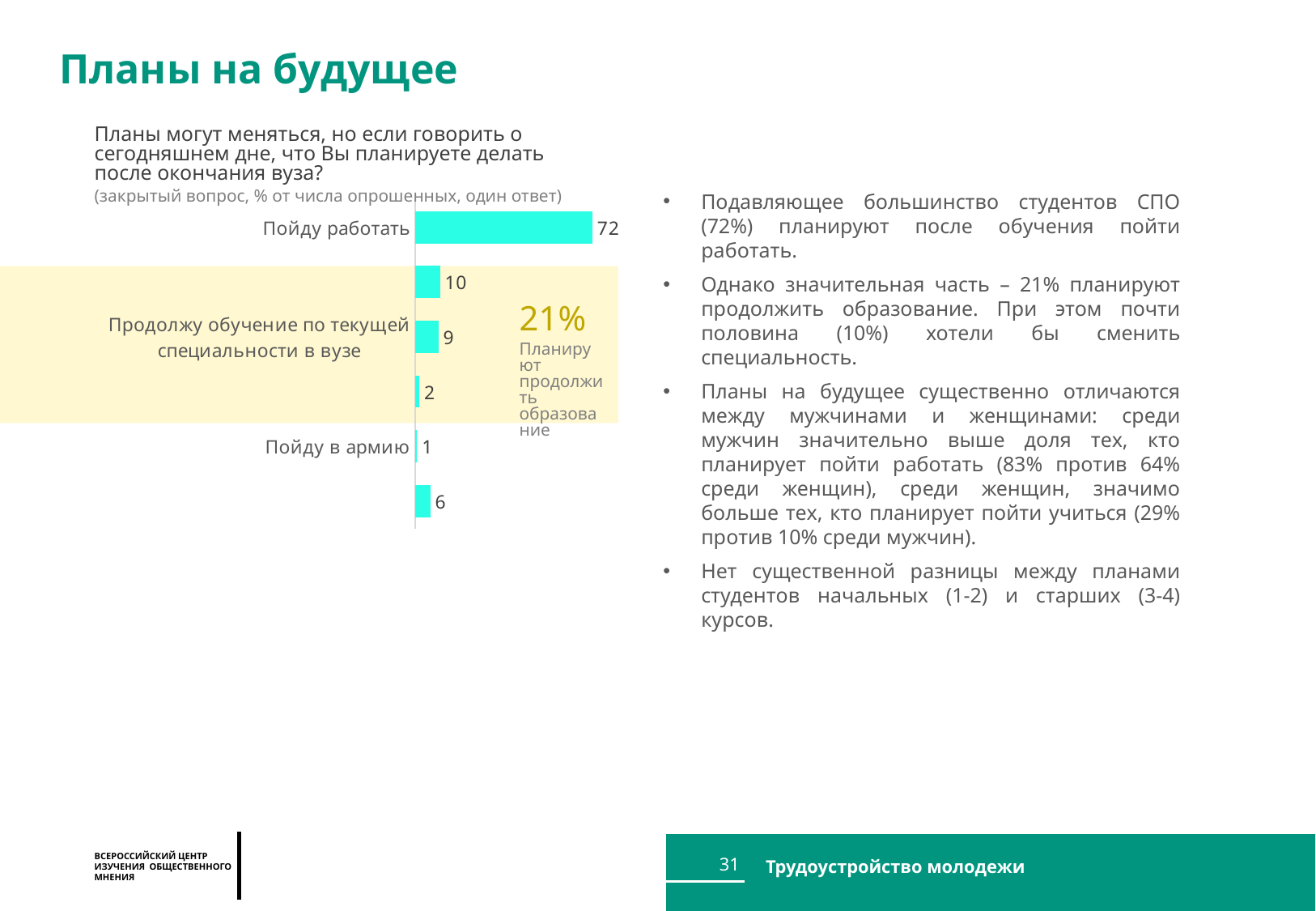
What type of chart is shown on the slide? Bar chart Which is larger, the value for "Пойду работать" or the value for "Пойду в армию"? Пойду работать Which category has the highest value in the chart? Пойду работать How many bars are plotted in the chart? 6 What is the total of the three bars in the yellow highlighted area (10, 9 and 2)? 21 What is the difference between the values for "Пойду работать" and "Пойду в армию"? 71 What value is shown for "Пойду в армию"? 1 What percentage is highlighted in the yellow area of the chart as planning to continue education? 21% What value is shown for "Пойду работать"? 72 What value is shown for the bar labelled "Продолжу обучение по текущей специальности в вузе"? 9 Which labelled category has the lowest value in the chart? Пойду в армию Is the value for "Пойду работать" greater or less than 50? greater